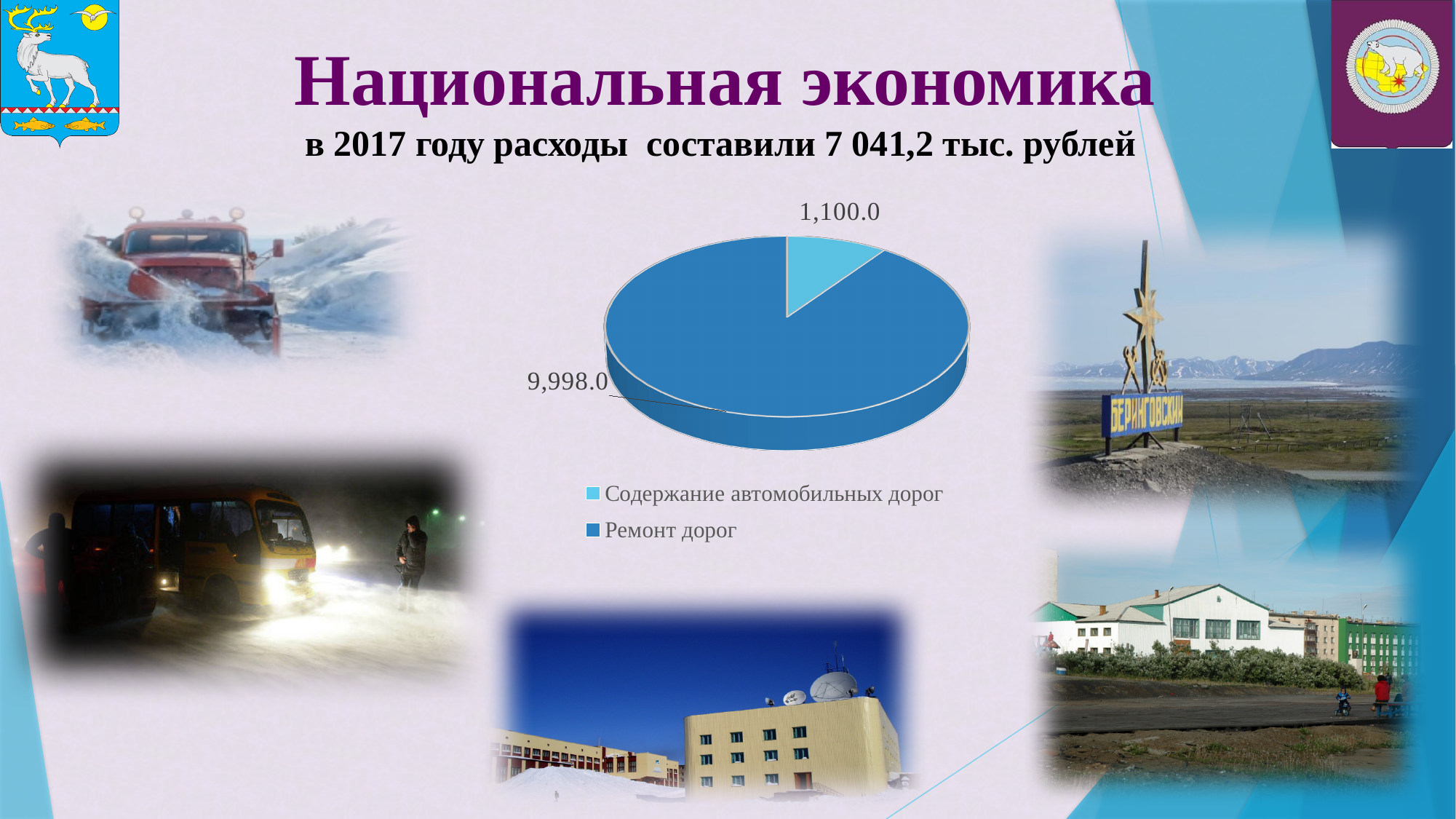
What is the value for Ремонт дорог in the pie chart? 9,998.0 Which category has the smallest slice in the pie chart? Содержание автомобильных дорог What is the total of the two values shown in the pie chart? 11,098.0 What is the difference between the values for Ремонт дорог and Содержание автомобильных дорог? 8,898.0 Which is larger: the value for Ремонт дорог or the value for Содержание автомобильных дорог? Ремонт дорог What is the value for Содержание автомобильных дорог in the pie chart? 1,100.0 Which colour represents Содержание автомобильных дорог in the pie chart? light blue Where is the legend positioned relative to the pie chart? below the chart What type of chart is shown on the slide? pie chart Which category has the largest slice in the pie chart? Ремонт дорог How many entries does the legend of the pie chart list? 2 How many slices does the pie chart have? 2